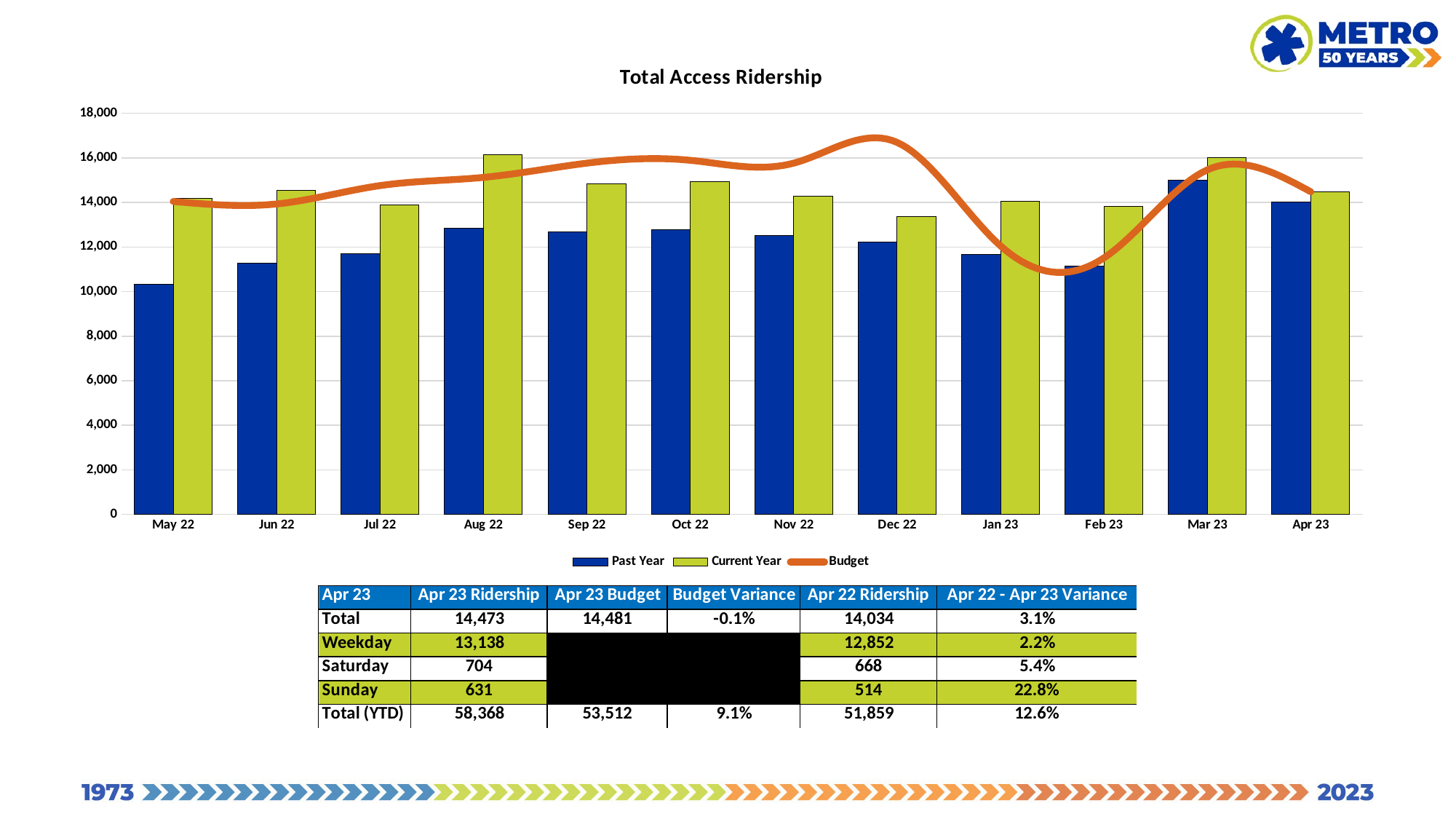
How many series does the legend list? 3 What is the title of the chart? Total Access Ridership How many months are shown on the x axis? 12 In May 22, which is larger, the Past Year bar or the Current Year bar? Current Year Is the Past Year value for May 22 greater or less than 12,000? less Do the Past Year values rise or fall from May 22 to Aug 22? rise What kind of chart is shown on the slide? bar chart with a line Which month has the lowest Past Year value? May 22 In which month does the Budget line reach its highest point? Dec 22 Which month has the highest Past Year value? Mar 23 Is the Current Year value for Oct 22 greater or less than 16,000? less Which month has the lowest Current Year value? Dec 22